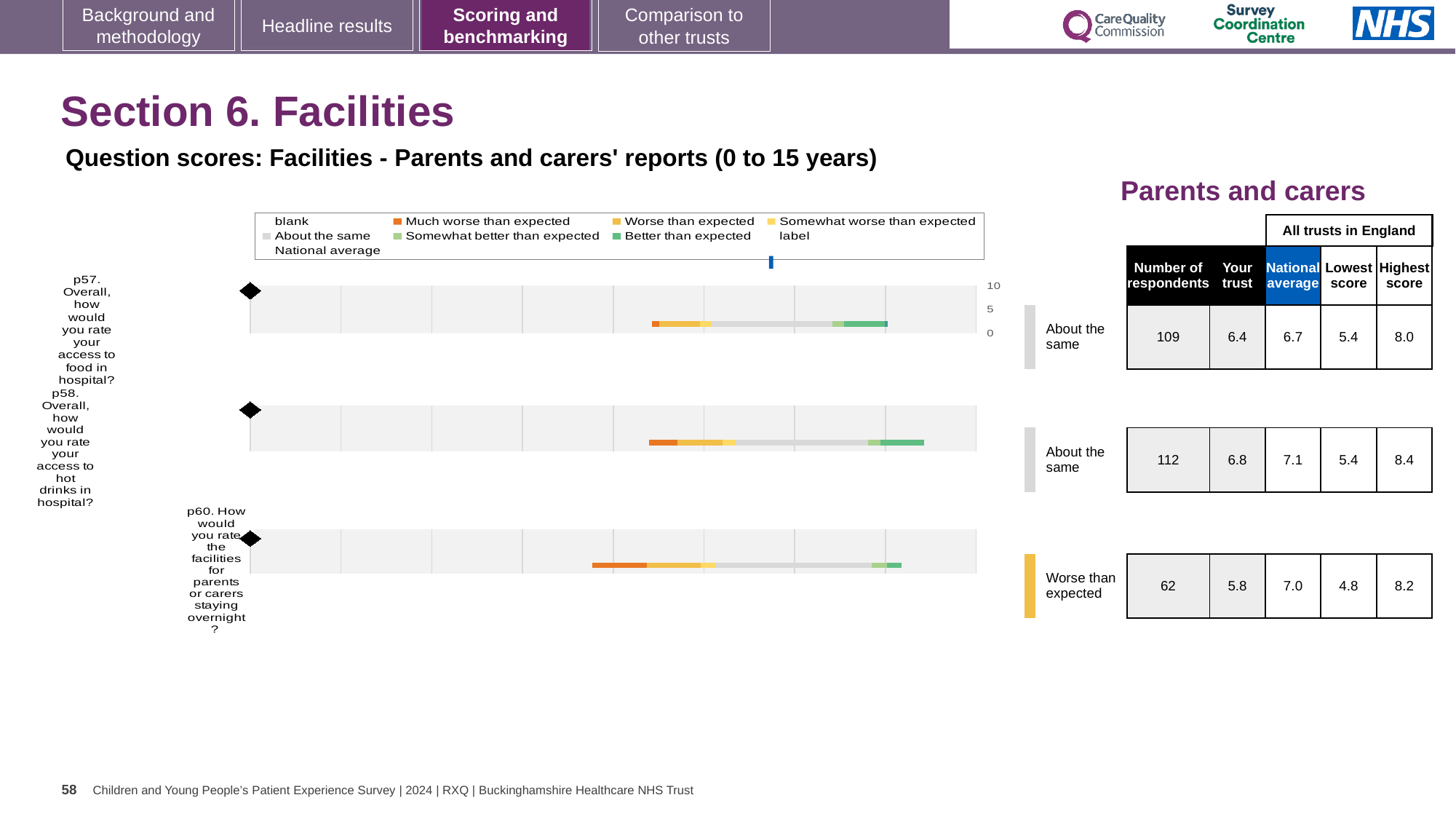
What is the 'Your trust' score for p57 (access to food in hospital)? 6.4 Which has the higher 'Your trust' score, p57 or p58? p58 What is the national average score for p58 (access to hot drinks in hospital)? 7.1 What is the highest score across all trusts in England for p58? 8.4 What is the lowest score across all trusts in England for p60? 4.8 Which question has the highest 'Highest score' across all trusts in England? p58 Which question has the lowest 'Your trust' score? p60 What benchmark category is shown for p60 (facilities for parents or carers staying overnight)? Worse than expected How many respondents answered p60 (facilities for parents or carers staying overnight)? 62 What is the difference between the national average and the 'Your trust' score for p60? 1.2 How many questions (p57, p58, p60) are plotted in the chart? 3 What kind of chart is used to show the question scores on this slide? Bar chart